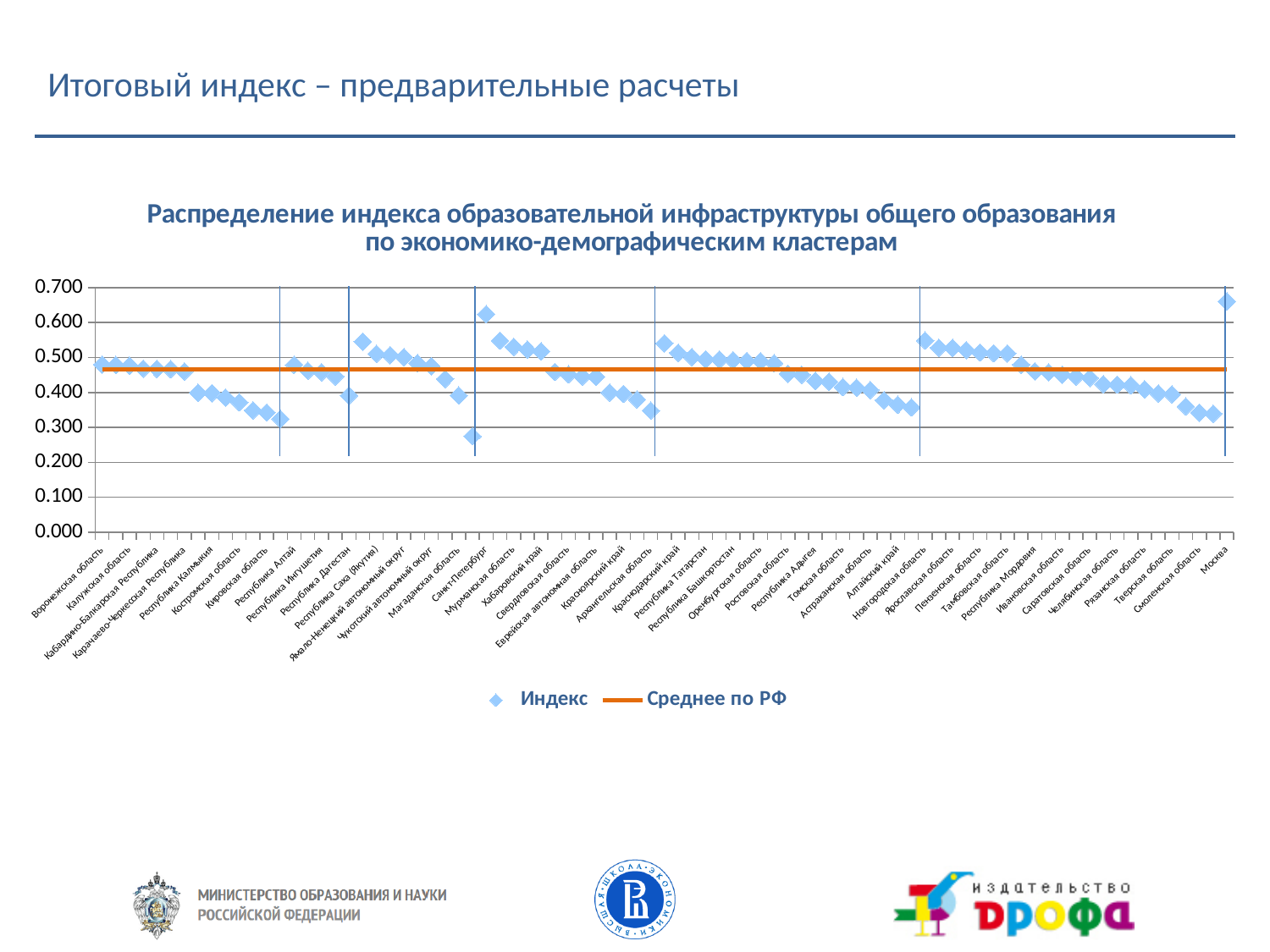
Is the Среднее по РФ line above or below 0.500 on the y axis? below What kind of chart is shown on the slide? scatter chart How many series does the legend list? 2 Which has the larger index value, Москва or Санкт-Петербург? Москва Is the index value for Москва greater or less than 0.600? greater What are the two entries in the chart legend? Индекс, Среднее по РФ Is the index value for Санкт-Петербург greater or less than 0.300? greater Which region has the highest index value on the chart? Москва Which has the larger index value, Мурманская область or Санкт-Петербург? Санкт-Петербург What is the title of the chart? Распределение индекса образовательной инфраструктуры общего образования по экономико-демографическим кластерам